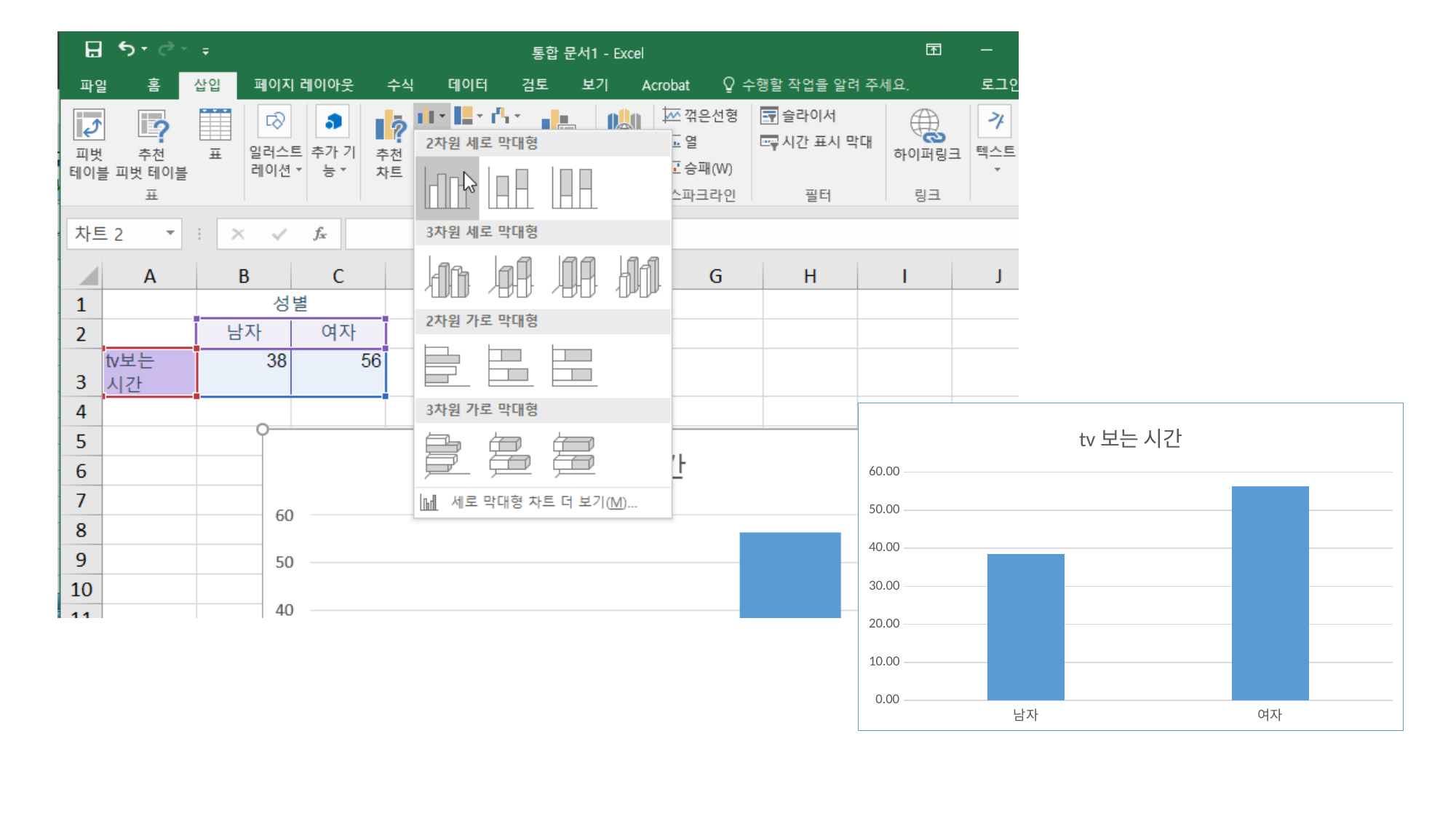
According to the spreadsheet data plotted in the chart 'tv 보는 시간', what is the value for 남자? 38 What is the title of the bar chart on the right side of the slide? tv 보는 시간 In the chart titled 'tv 보는 시간', which bar is taller, 남자 or 여자? 여자 In the chart titled 'tv 보는 시간', is the bar for 남자 greater or less than 30.00? greater In the chart titled 'tv 보는 시간', which category has the lowest bar? 남자 In the chart titled 'tv 보는 시간', is the bar for 남자 greater or less than 40.00? less In the chart titled 'tv 보는 시간', is the bar for 여자 greater or less than 50.00? greater In the chart titled 'tv 보는 시간', which category has the highest bar? 여자 In the chart titled 'tv 보는 시간', what type of chart is shown? bar chart In the chart titled 'tv 보는 시간', how many categories are shown on the x axis? 2 According to the spreadsheet data plotted in the chart 'tv 보는 시간', what is the value for 여자? 56 Using the spreadsheet values plotted in the chart 'tv 보는 시간', what is the difference between 여자 and 남자? 18